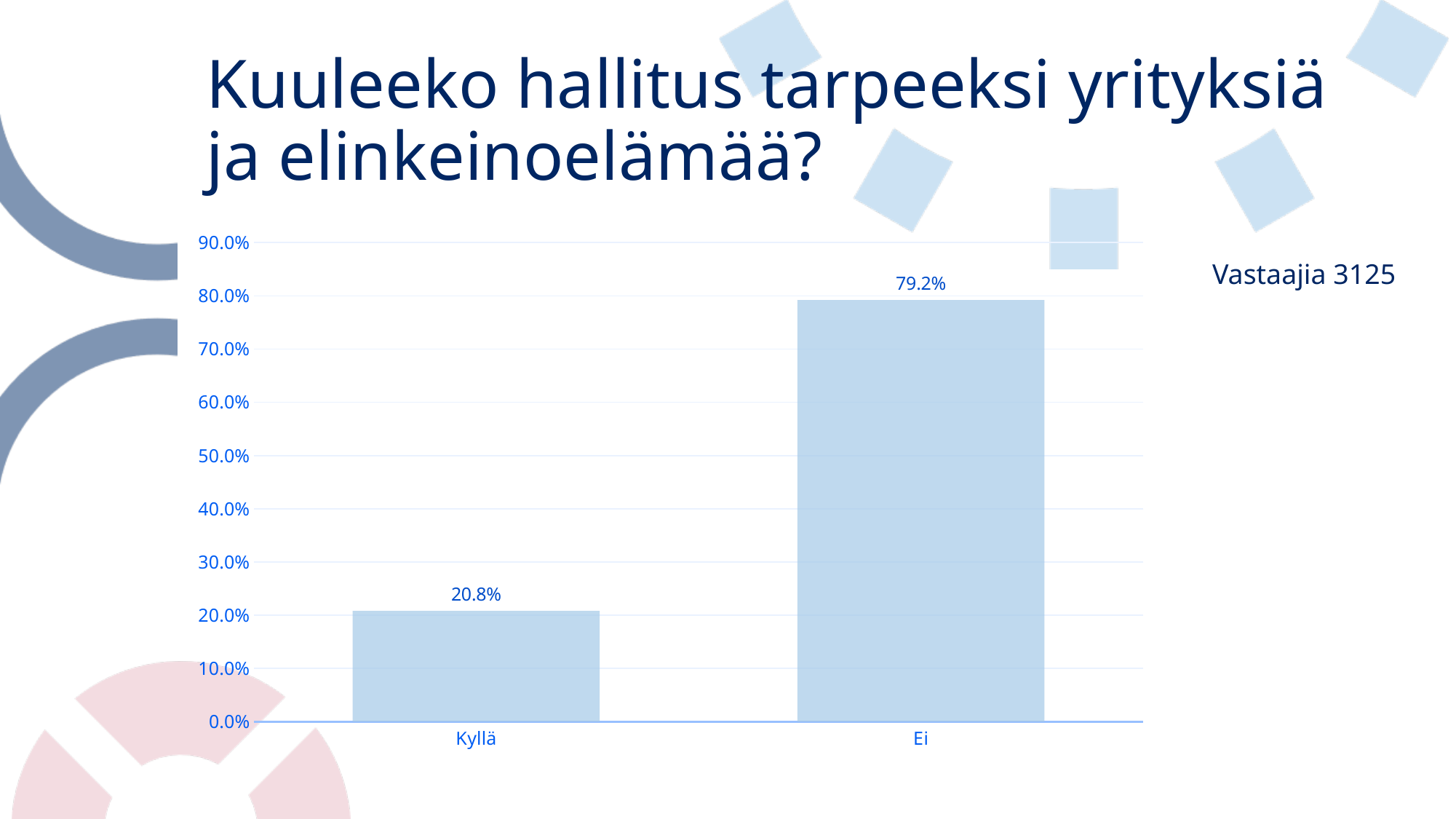
Which category has the lowest value? Kyllä Is the value for Kyllä greater or less than 30.0%? less How many respondents (Vastaajia) does the slide state? 3125 What is the highest value shown on the y axis? 90.0% What kind of chart is shown on the slide? bar chart What is the value for Kyllä? 20.8% What is the value for Ei? 79.2% How many categories are shown on the x axis? 2 Is the value for Ei greater or less than 70.0%? greater What is the difference between the values for Ei and Kyllä? 58.4% Which category has the highest value? Ei Which is larger, the value for Kyllä or the value for Ei? Ei